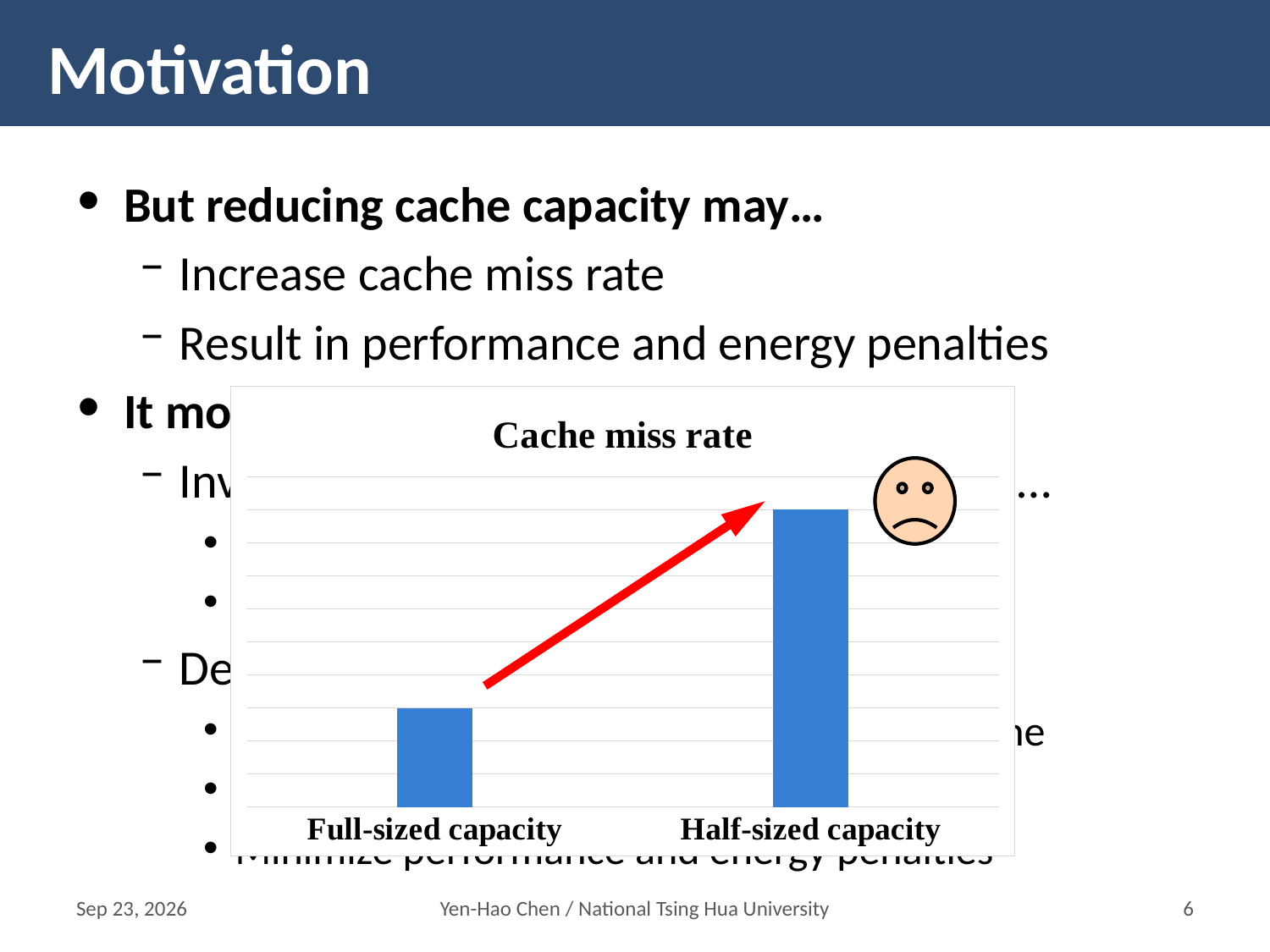
What kind of chart is shown on the slide? bar chart Which category has the highest cache miss rate? Half-sized capacity Which has a larger cache miss rate, Full-sized capacity or Half-sized capacity? Half-sized capacity What is the label of the first category on the x axis of the chart? Full-sized capacity What is the title of the chart? Cache miss rate Which category has the lowest cache miss rate? Full-sized capacity How many categories are plotted in the Cache miss rate chart? 2 Does the cache miss rate rise or fall from Full-sized capacity to Half-sized capacity? rise What colour are the bars in the Cache miss rate chart? blue